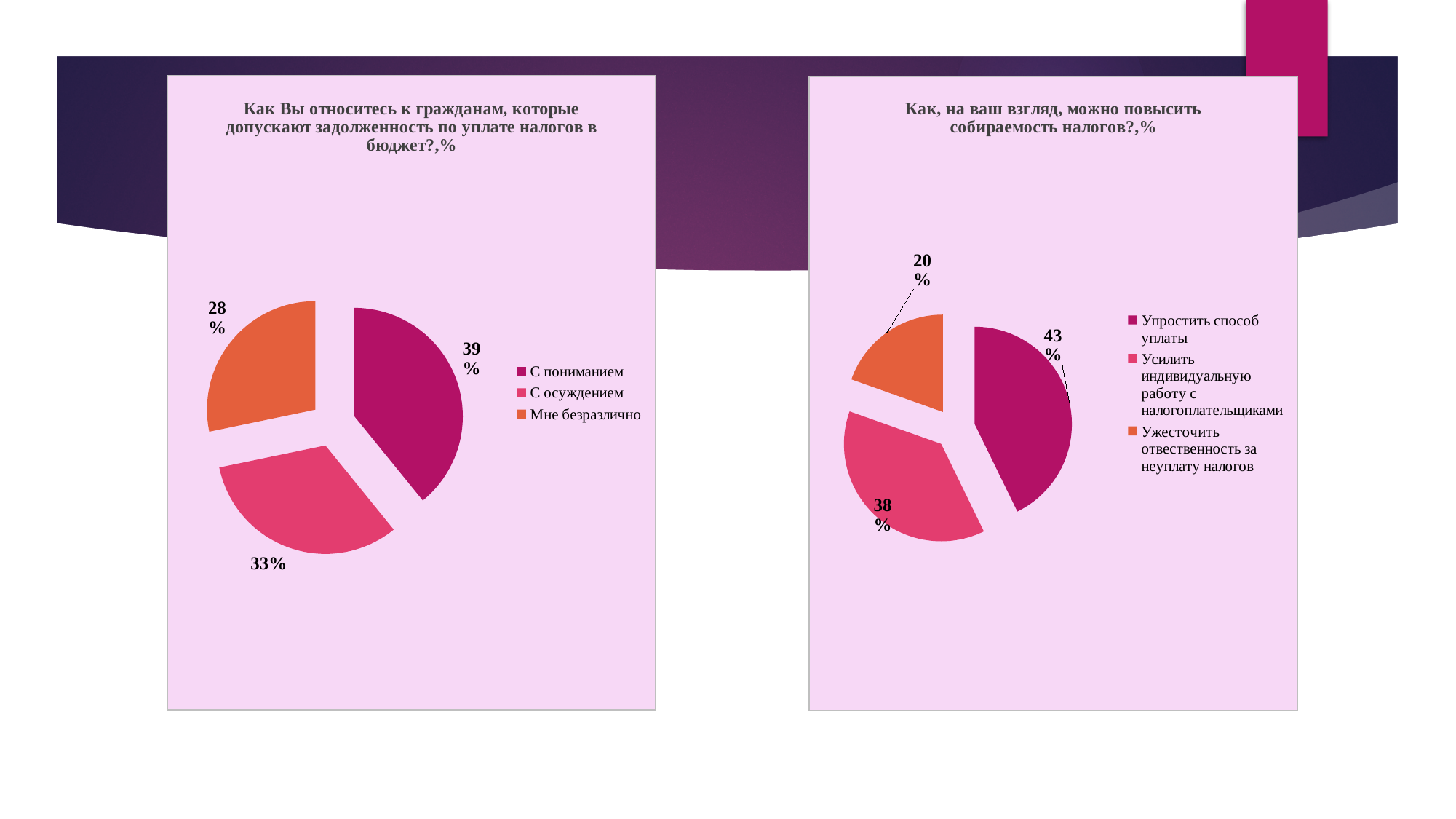
In the right pie chart, which option has the largest share? Упростить способ уплаты In the left pie chart, what share of respondents answered "С пониманием"? 39% In the right pie chart, what share of respondents chose "Упростить способ уплаты"? 43% In the right pie chart, what is the difference in percentage points between "Упростить способ уплаты" and "Ужесточить ответственность за неуплату налогов"? 23 In the right pie chart, what share of respondents chose "Ужесточить ответственность за неуплату налогов"? 20% In the left pie chart, which answer has the largest share? С пониманием In the right pie chart, which is larger: "Усилить индивидуальную работу с налогоплательщиками" or "Ужесточить ответственность за неуплату налогов"? Усилить индивидуальную работу с налогоплательщиками In the left pie chart, which answer has the smallest share? Мне безразлично In the left pie chart, what share of respondents answered "Мне безразлично"? 28% What type of chart is shown on the right side of the slide? Pie chart In the left pie chart, what is the difference in percentage points between "С пониманием" and "С осуждением"? 6 How many slices does the left pie chart have? 3